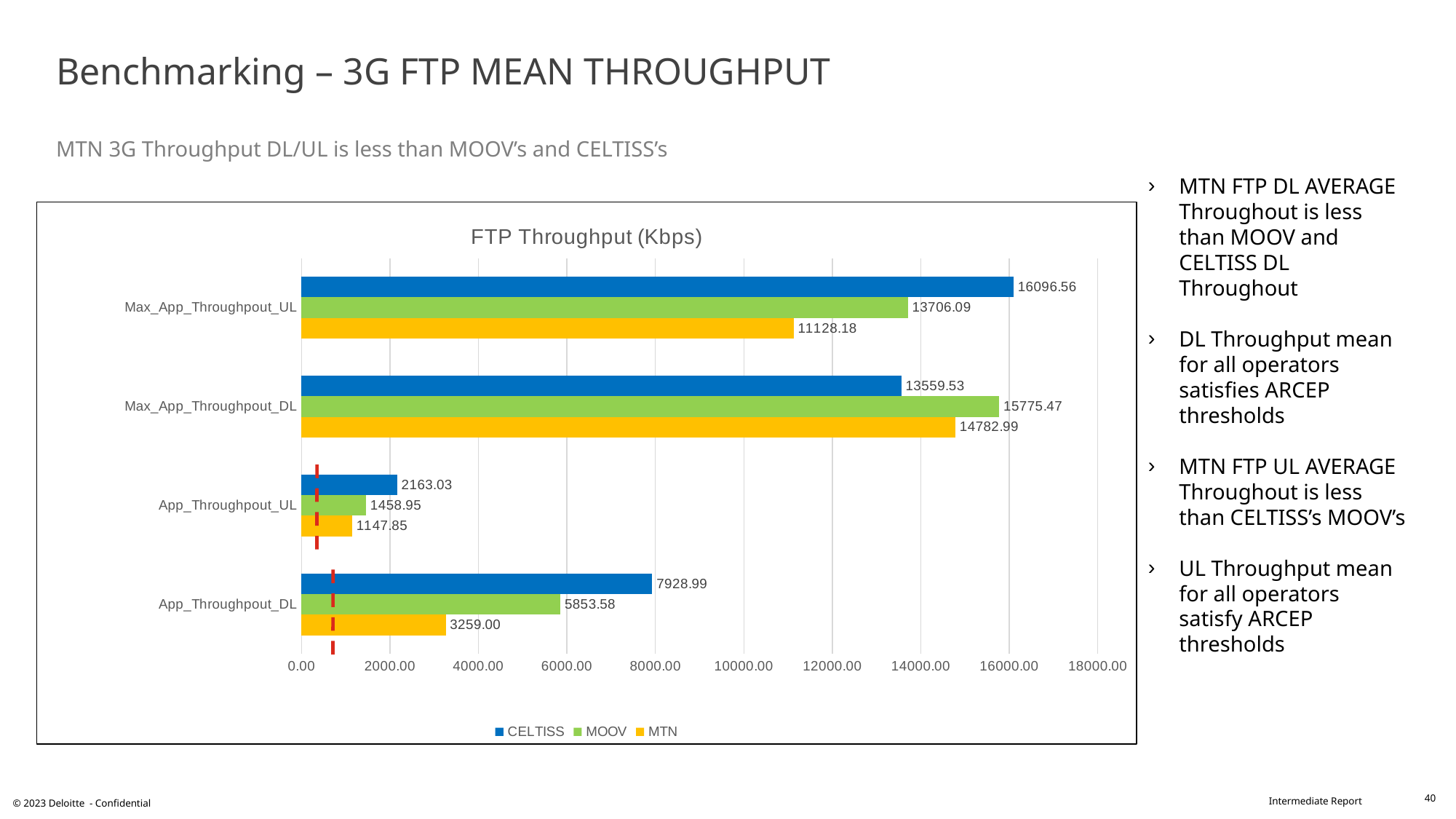
Which operator has the highest value for App_Throughpout_UL? CELTISS Which operator has the lowest value for Max_App_Throughpout_DL? CELTISS What is the difference between the CELTISS and MTN values for App_Throughpout_DL? 4669.99 How many series does the legend list? 3 Which is larger for Max_App_Throughpout_UL: the MOOV value or the MTN value? MOOV How many categories are shown on the y axis of the chart? 4 What is the MTN value for App_Throughpout_DL? 3259.00 What is the CELTISS value for Max_App_Throughpout_UL? 16096.56 What is the MOOV value for Max_App_Throughpout_DL? 15775.47 Is the MTN value for Max_App_Throughpout_UL greater or less than 12000.00? less What is the title of the chart? FTP Throughput (Kbps) What kind of chart is shown on the slide? Bar chart